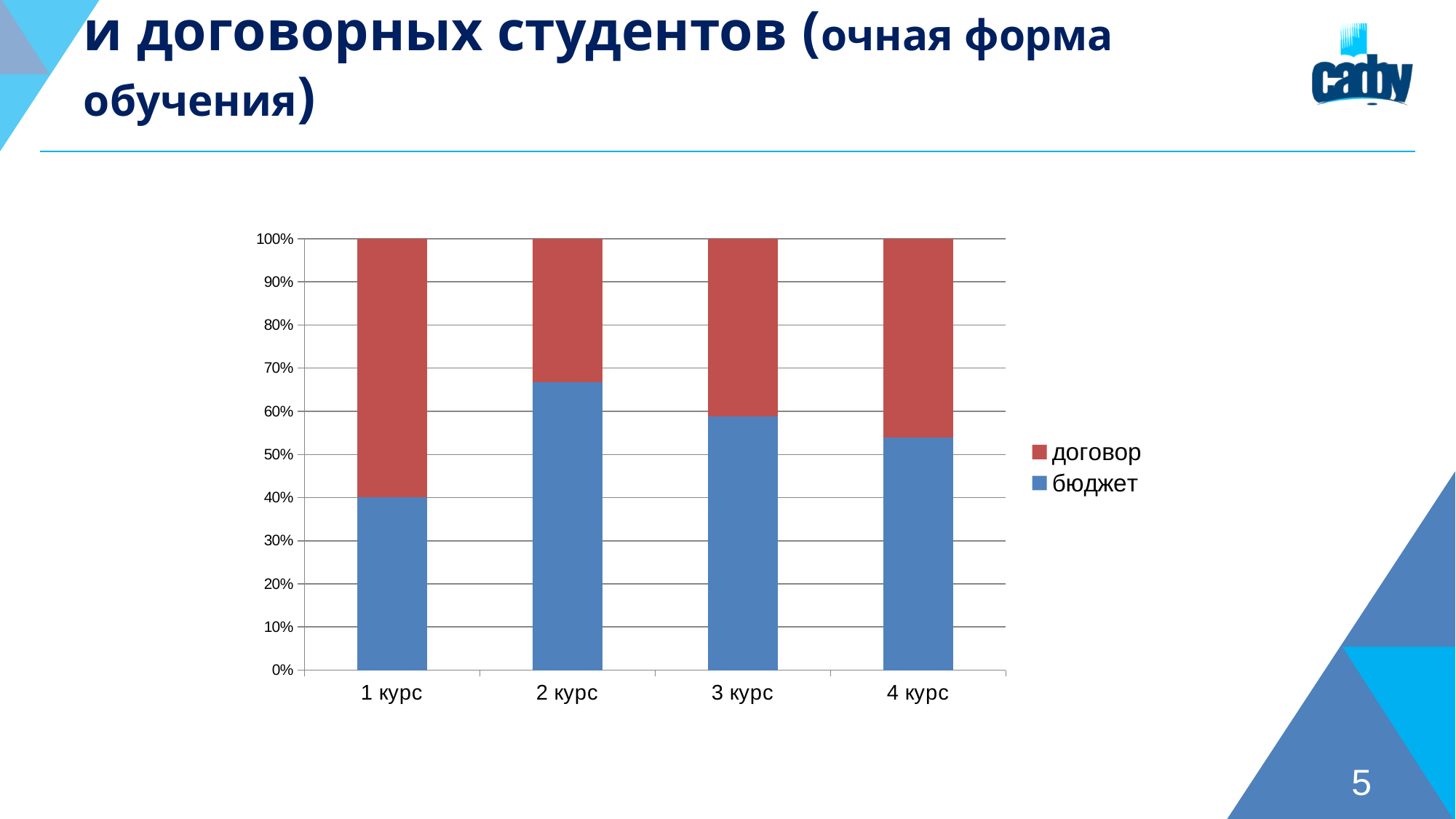
Is the бюджет share for 4 курс greater or less than 50%? greater Which series is shown in red in the legend? договор For which course is the бюджет share the lowest? 1 курс Which is larger, the бюджет share for 2 курс or for 4 курс? 2 курс Is the бюджет share for 2 курс greater or less than 60%? greater How many series does the legend list? 2 Which series is shown in blue in the legend? бюджет What kind of chart is shown on the slide? stacked bar chart For which course is the бюджет share the highest? 2 курс What is the value of бюджет for 1 курс? 40% For which course is the договор share the highest? 1 курс How many categories (courses) are shown on the x axis? 4